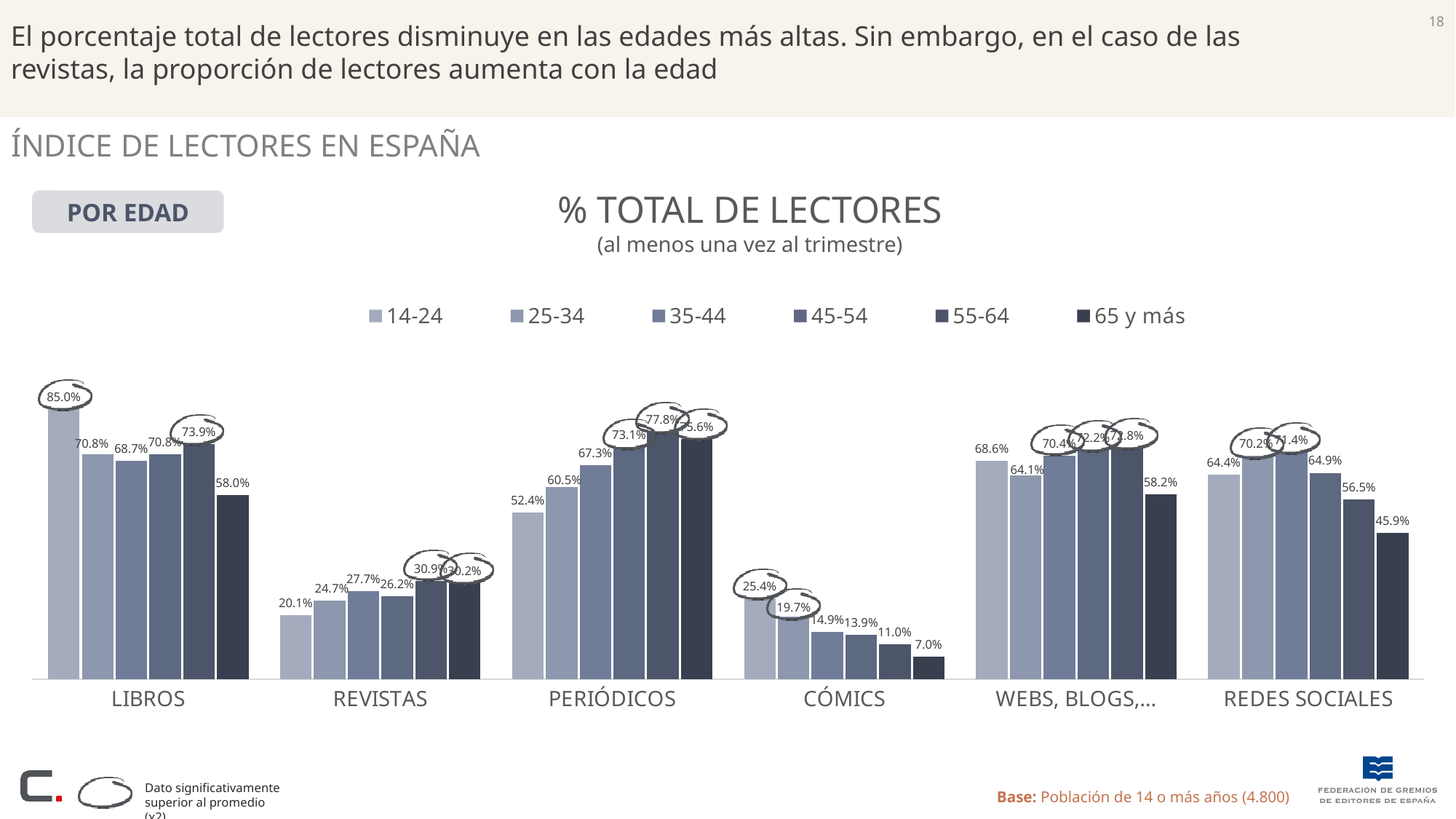
In the REVISTAS category, which is larger: the 14-24 value or the 25-34 value? 25-34 In the LIBROS category, what is the difference between the 14-24 value and the 65 y más value? 27.0 percentage points In the CÓMICS category, do the values rise or fall as the age groups get older? Fall What is the value for the 65 y más age group in the CÓMICS category? 7.0% What is the value for the 14-24 age group in the PERIÓDICOS category? 52.4% What is the value for the 65 y más age group in the REDES SOCIALES category? 45.9% How many age-group series does the legend list? 6 Within the LIBROS category, which age group has the lowest value? 65 y más What is the value for the 14-24 age group in the LIBROS category? 85.0% Within the CÓMICS category, which age group has the highest value? 14-24 What kind of chart is shown on the slide? Bar chart How many categories are shown on the x axis of the chart? 6